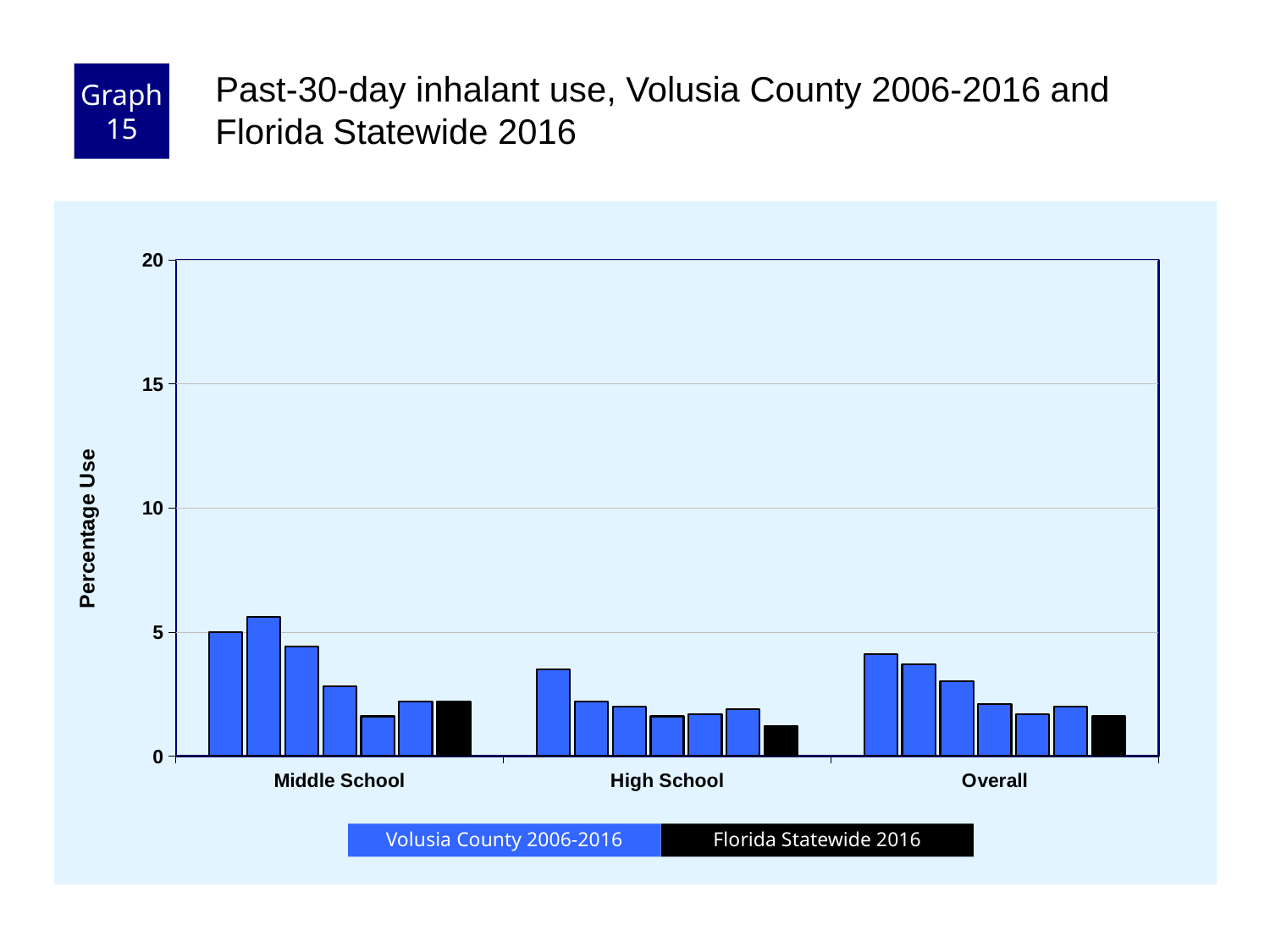
What kind of chart is shown on the slide? bar chart Do the Volusia County 2006-2016 bars in the High School group generally rise or fall from left to right? fall Which is larger, the Florida Statewide 2016 bar for Middle School or the Florida Statewide 2016 bar for High School? Middle School Is the tallest Volusia County bar in the Middle School group greater or less than 5? greater How many bars are plotted in the Middle School group? 7 How many categories are shown on the x axis? 3 What is the label on the vertical axis? Percentage Use Which x-axis group has the lowest Florida Statewide 2016 bar? High School Is the tallest bar in the High School group greater or less than 5? less Which x-axis group contains the tallest bar on the chart? Middle School How many series does the legend list? 2 Is the Florida Statewide 2016 value for Overall greater or less than 5? less